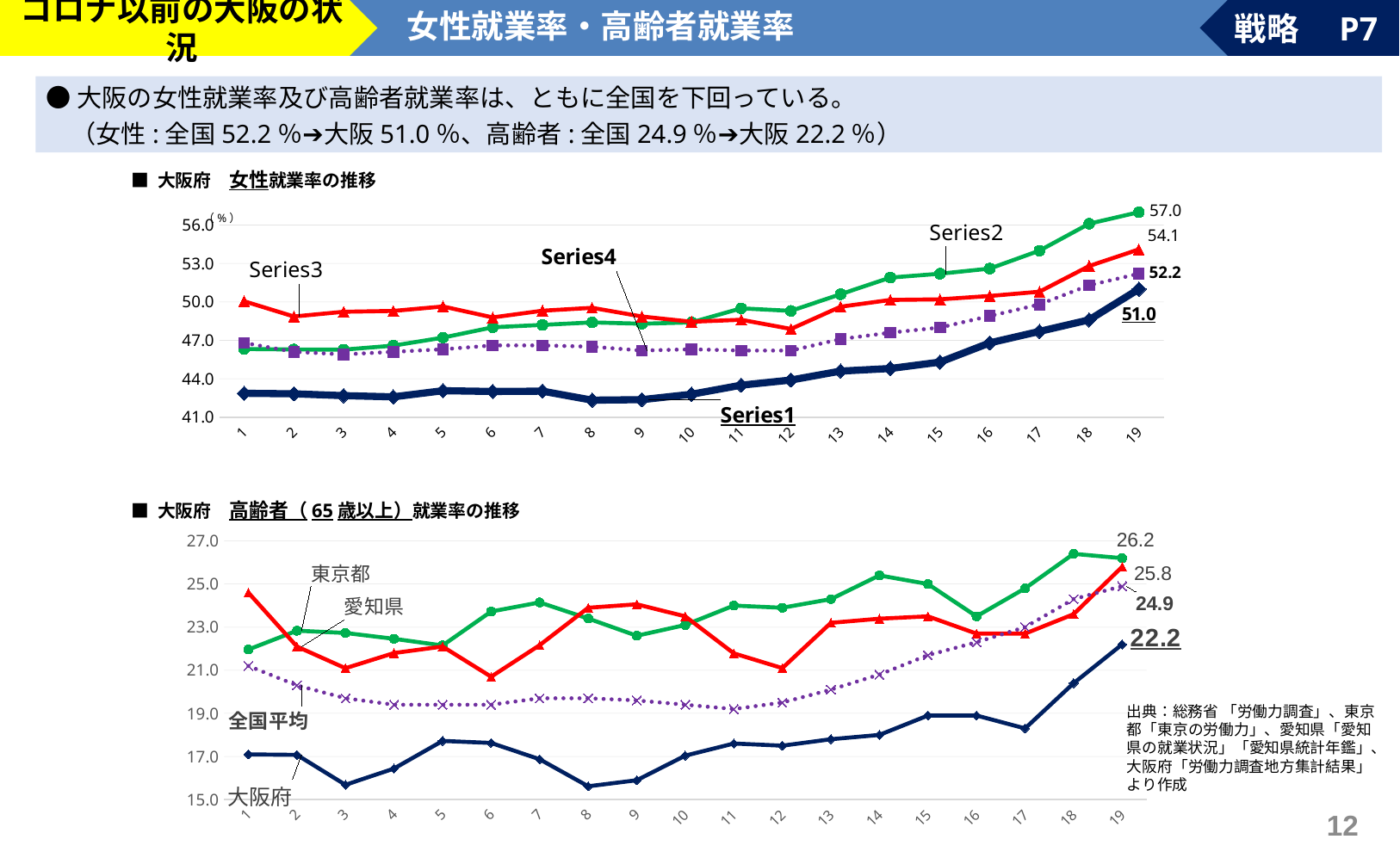
In the top chart (大阪府 女性就業率の推移), what is the difference between Series2 and Series1 at point 19? 6.0 In the top chart (大阪府 女性就業率の推移), what is the value of Series4 at point 19? 52.2 In the top chart (大阪府 女性就業率の推移), what is the value of Series1 at point 19? 51.0 In the bottom chart (大阪府 高齢者就業率の推移), which series has the lowest value at point 19? 大阪府 In the top chart (大阪府 女性就業率の推移), what is the value of Series2 at point 19? 57.0 In the top chart (大阪府 女性就業率の推移), which series has the highest value at point 19? Series2 In the bottom chart (大阪府 高齢者就業率の推移), what is the value for 大阪府 at point 19? 22.2 In the bottom chart (大阪府 高齢者就業率の推移), what is the value for 全国平均 at point 19? 24.9 How many points are on the x axis of the top chart (大阪府 女性就業率の推移)? 19 In the top chart (大阪府 女性就業率の推移), what is the value of Series3 at point 19? 54.1 What kind of chart is the top chart (大阪府 女性就業率の推移)? Line chart In the bottom chart (大阪府 高齢者就業率の推移), is the value for 大阪府 at point 8 greater or less than 17.0? less